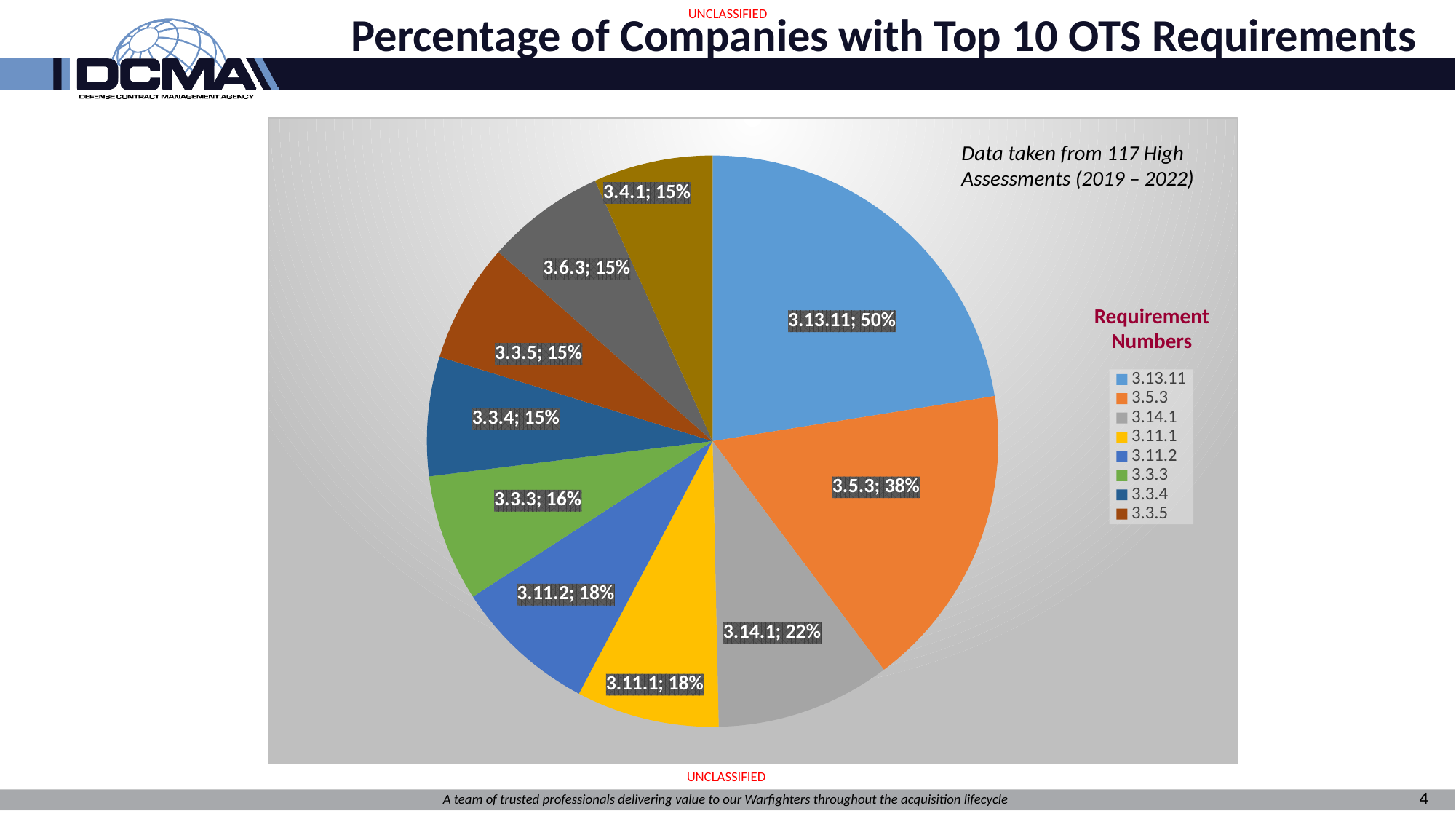
What percentage is shown for requirement 3.5.3? 38% Which requirement number has the highest percentage in the pie chart? 3.13.11 What is the difference in percentage points between requirement 3.14.1 and requirement 3.11.1? 4 What type of chart is shown on the slide? Pie chart What percentage is shown for requirement 3.3.3? 16% What is the title of the chart's legend? Requirement Numbers How many slices does the pie chart have? 10 Which has the larger percentage, requirement 3.3.3 or requirement 3.3.4? 3.3.3 How many entries are listed in the chart's legend? 8 What percentage is shown for requirement 3.14.1? 22% What is the difference in percentage points between requirement 3.13.11 and requirement 3.5.3? 12 What percentage is shown for requirement 3.13.11? 50%